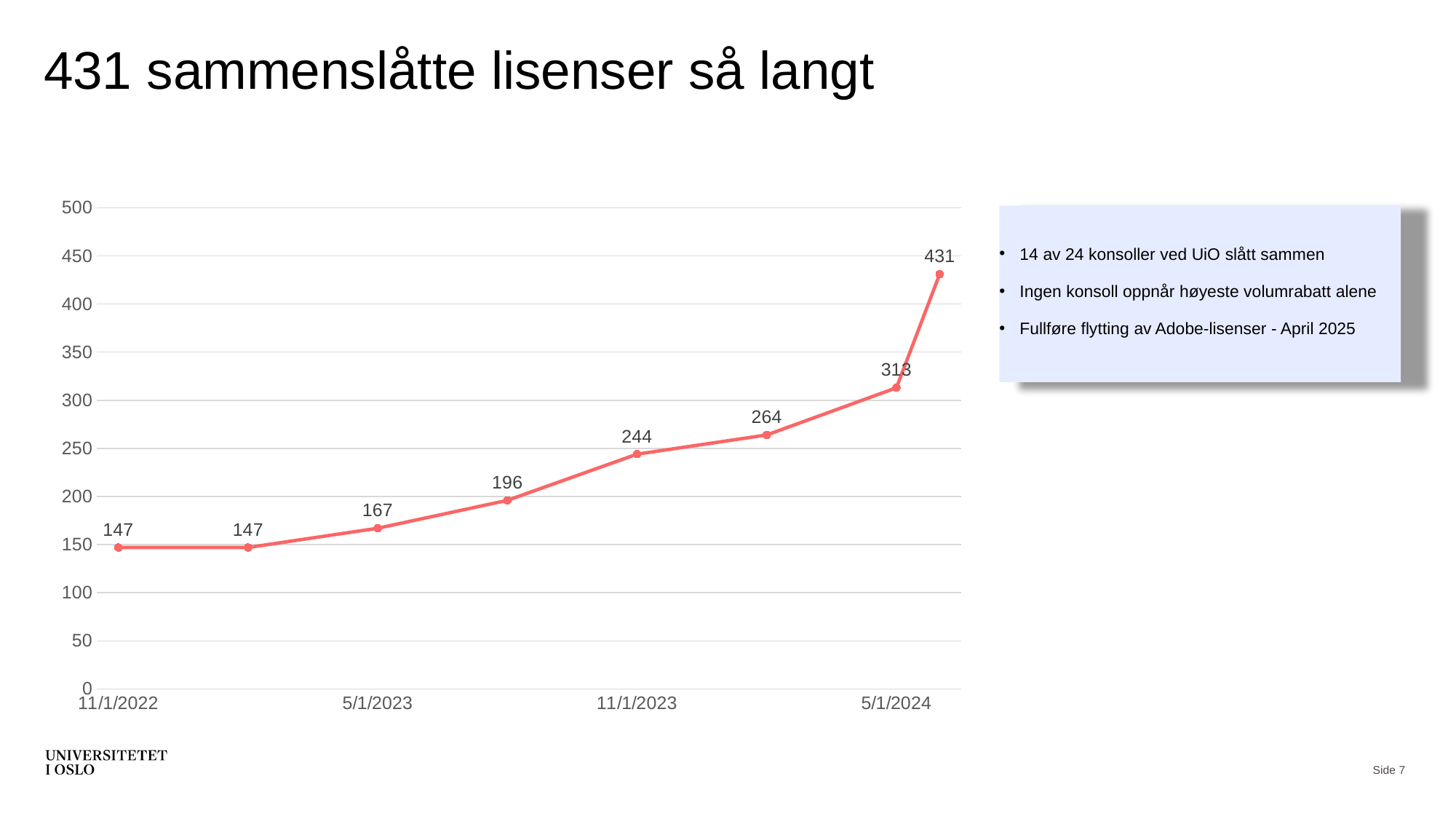
How many data points are plotted on the line? 8 What is the lowest value plotted on the chart? 147 Is the value of the data point labelled 264 greater or less than 250? greater What is the value of the data point at 5/1/2024? 313 What is the value of the data point at 11/1/2023? 244 Do the values generally rise or fall from left to right along the x axis? rise What is the value of the last data point on the line? 431 What kind of chart is shown on the slide? line chart What is the difference between the last data point (431) and the data point at 5/1/2024 (313)? 118 What is the highest value plotted on the chart? 431 What is the value of the data point at 5/1/2023? 167 What is the value of the first data point, at 11/1/2022? 147